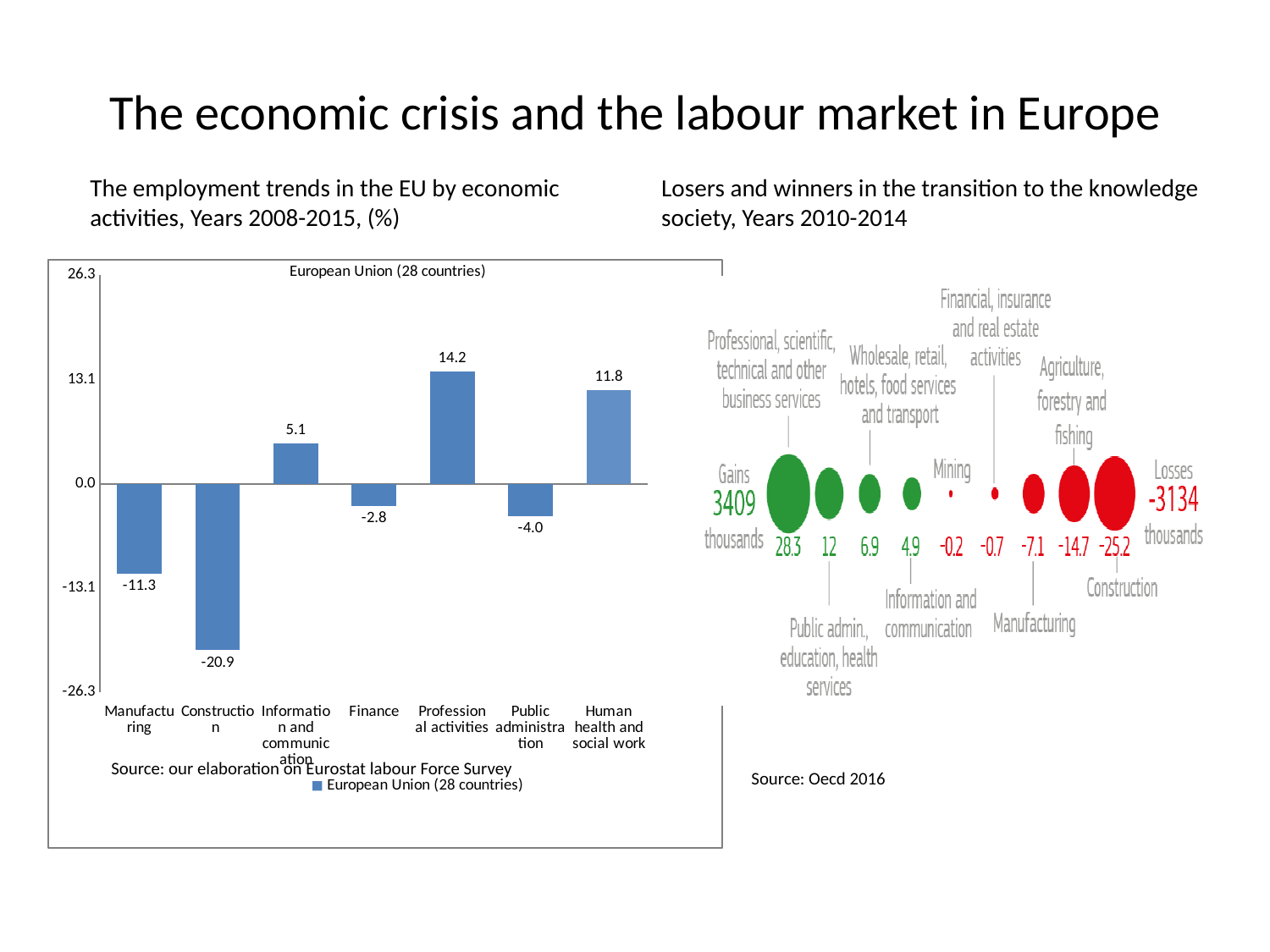
In the left chart (European Union 28 countries), how many series does the legend list? 1 In the left chart (European Union 28 countries), which category has the highest value? Professional activities In the right chart (Losers and winners in the transition to the knowledge society), what is the total of Gains in thousands? 3409 In the right chart (Losers and winners in the transition to the knowledge society), what is the value for Construction? -25.2 In the right chart (Losers and winners in the transition to the knowledge society), which sector has the largest gain? Professional, scientific, technical and other business services What kind of chart is the left chart (European Union 28 countries)? Bar chart In the left chart (European Union 28 countries), how many categories are shown on the x axis? 7 In the left chart (European Union 28 countries), which is larger, the value for Finance or the value for Public administration? Finance In the left chart (European Union 28 countries), which category has the lowest value? Construction In the left chart (European Union 28 countries), what is the value for Professional activities? 14.2 In the left chart (European Union 28 countries), what is the value for Construction? -20.9 In the left chart (European Union 28 countries), what is the difference between the values for Professional activities and Human health and social work? 2.4